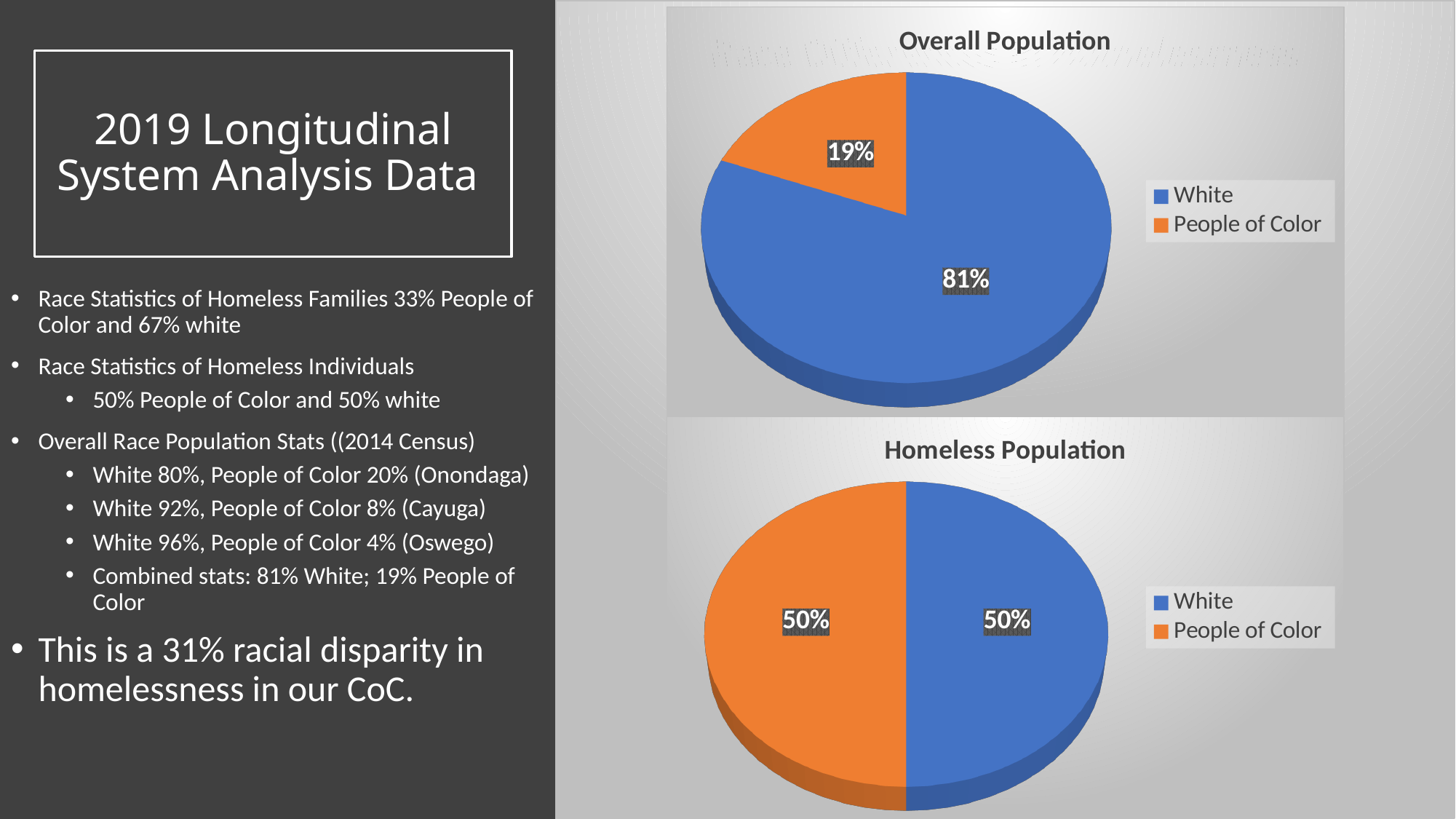
In the Overall Population chart, what share of the pie is White? 81% In the Overall Population chart, is the White slice larger or smaller than the People of Color slice? larger In the Overall Population chart, which category has the smallest slice? People of Color How many entries does the legend of the Overall Population chart list? 2 In the Overall Population chart, which category has the largest slice? White In the Overall Population chart, what is the difference between the White and People of Color shares? 62% In the Overall Population chart, what share of the pie is People of Color? 19% What is the title of the bottom chart on the slide? Homeless Population How many slices does the Homeless Population pie chart have? 2 In the Homeless Population chart, what share of the pie is People of Color? 50% In the Homeless Population chart, what colour is the People of Color slice? orange What kind of chart is the Homeless Population chart? pie chart